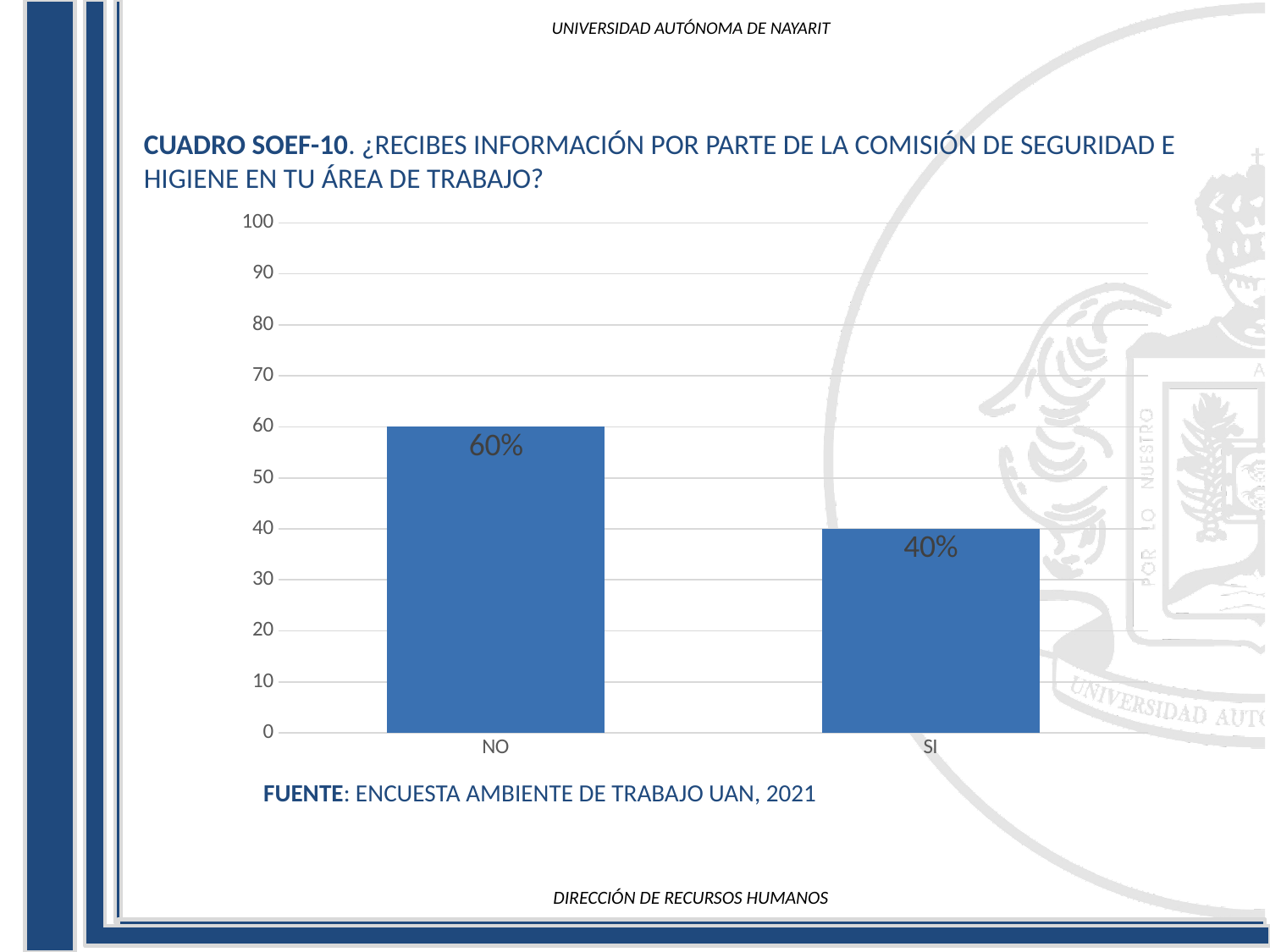
Is the value for SI greater or less than 50? less What source is cited below the chart? ENCUESTA AMBIENTE DE TRABAJO UAN, 2021 What is the value for NO? 60% Which is larger, the value for NO or the value for SI? NO Which category has the lowest value? SI What kind of chart is shown on the slide? bar chart What is the difference between the values for NO and SI? 20% What is the value for SI? 40% Is the value for NO greater or less than 50? greater Which category has the highest value? NO What is the maximum value shown on the y axis? 100 How many categories are shown on the x axis? 2